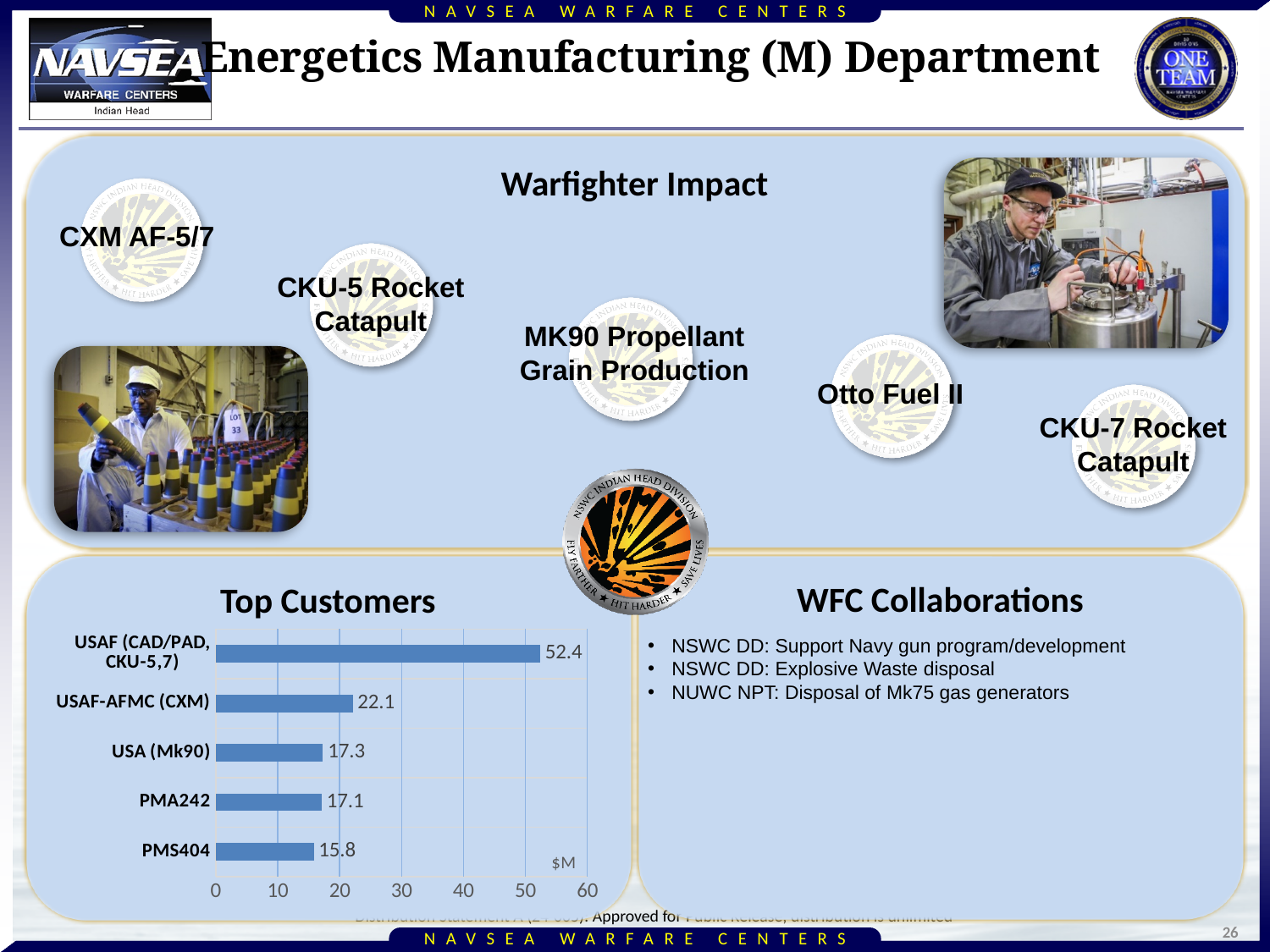
What is the value for USAF (CAD/PAD, CKU-5,7) in the Top Customers chart? 52.4 What is the value for USAF-AFMC (CXM) in the Top Customers chart? 22.1 Is the value for USAF (CAD/PAD, CKU-5,7) in the Top Customers chart greater or less than 50? greater What unit is indicated on the x axis of the Top Customers chart? $M What is the value for PMS404 in the Top Customers chart? 15.8 What is the difference between the values for USAF (CAD/PAD, CKU-5,7) and USAF-AFMC (CXM) in the Top Customers chart? 30.3 In the Top Customers chart, which is larger: the value for USAF-AFMC (CXM) or the value for PMA242? USAF-AFMC (CXM) Which customer has the highest value in the Top Customers chart? USAF (CAD/PAD, CKU-5,7) What is the difference between the values for USA (Mk90) and PMS404 in the Top Customers chart? 1.5 How many customers are shown in the Top Customers chart? 5 What kind of chart is the Top Customers chart? bar chart Which customer has the lowest value in the Top Customers chart? PMS404